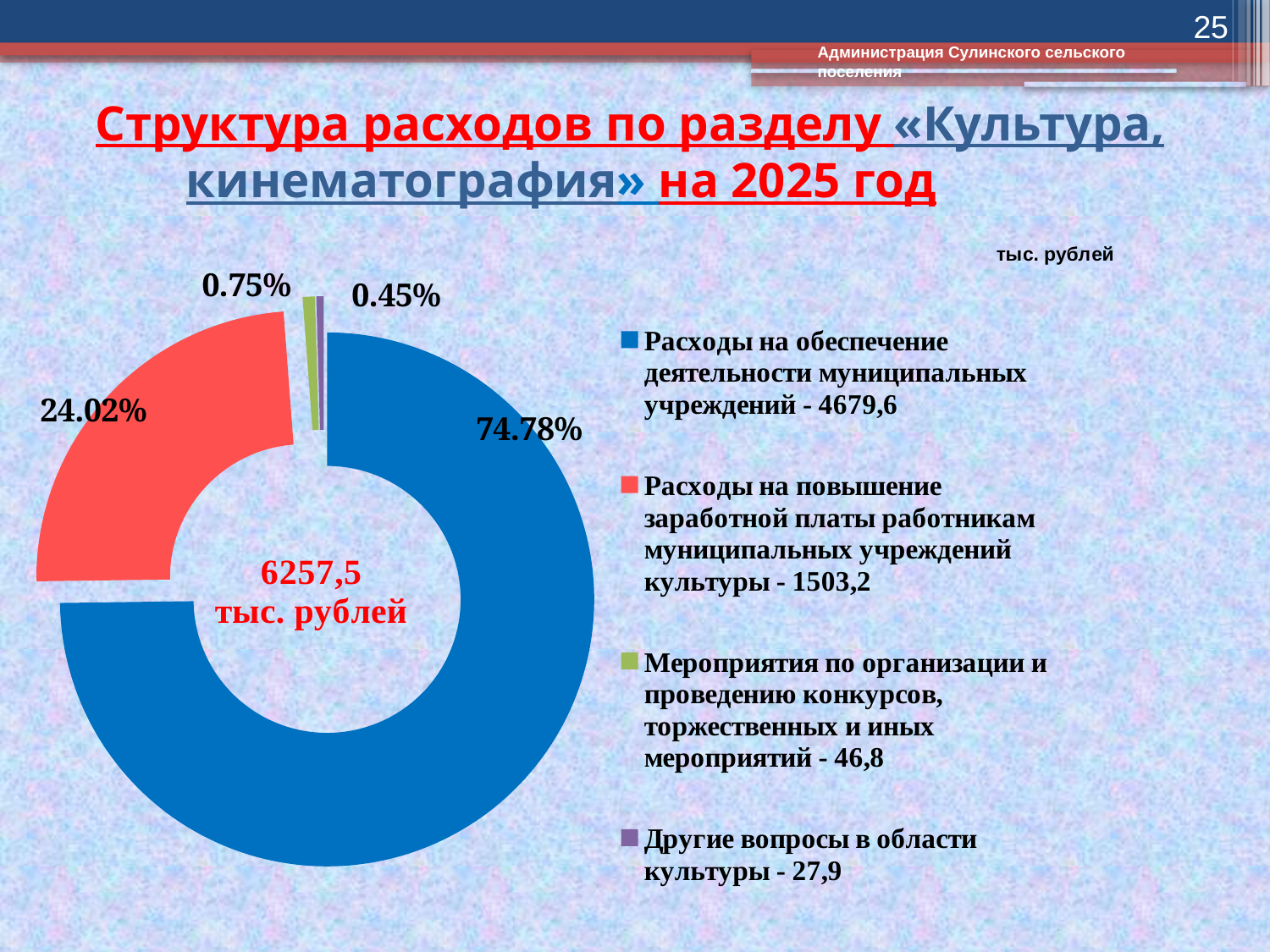
What share of the chart does the slice for «Мероприятия по организации и проведению конкурсов, торжественных и иных мероприятий» represent? 0.75% How many categories does the legend of the chart list? 4 What is the difference in percentage points between the largest slice (74.78%) and the second largest slice (24.02%)? 50.76% What is the value (тыс. рублей) shown in the legend for «Другие вопросы в области культуры»? 27,9 What share of the chart does the slice for «Расходы на обеспечение деятельности муниципальных учреждений» represent? 74.78% What total amount is shown in the centre of the chart? 6257,5 тыс. рублей What share of the chart does the slice for «Расходы на повышение заработной платы работникам муниципальных учреждений культуры» represent? 24.02% Which category has the smallest slice of the chart? Другие вопросы в области культуры What kind of chart is shown on the slide? Doughnut (pie) chart Which category has the largest slice of the chart? Расходы на обеспечение деятельности муниципальных учреждений What is the value (тыс. рублей) shown in the legend for «Расходы на обеспечение деятельности муниципальных учреждений»? 4679,6